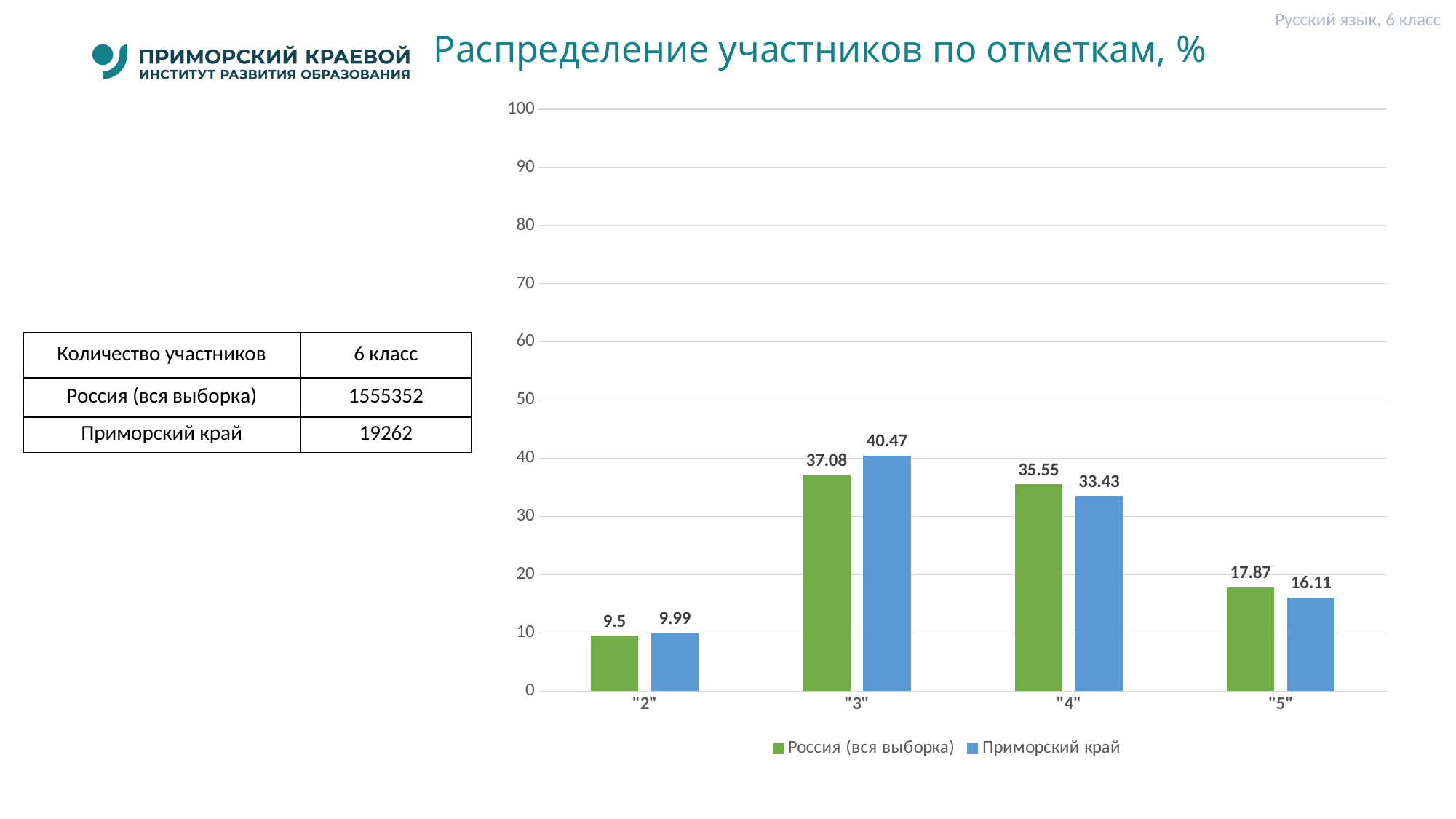
Which mark has the lowest value for Россия (вся выборка)? "2" Which mark has the highest value for Приморский край? "3" What is the value for Приморский край for mark "2"? 9.99 What is the value for Приморский край for mark "5"? 16.11 How many mark categories are shown on the x axis? 4 What is the difference between Приморский край and Россия (вся выборка) for mark "3"? 3.39 For mark "4", which series has the larger value: Россия (вся выборка) or Приморский край? Россия (вся выборка) What kind of chart is shown on the slide? bar chart What is the title of the chart? Распределение участников по отметкам, % How many series does the legend list? 2 What is the value for Россия (вся выборка) for mark "3"? 37.08 Is the value for Россия (вся выборка) for mark "5" greater or less than 20? less